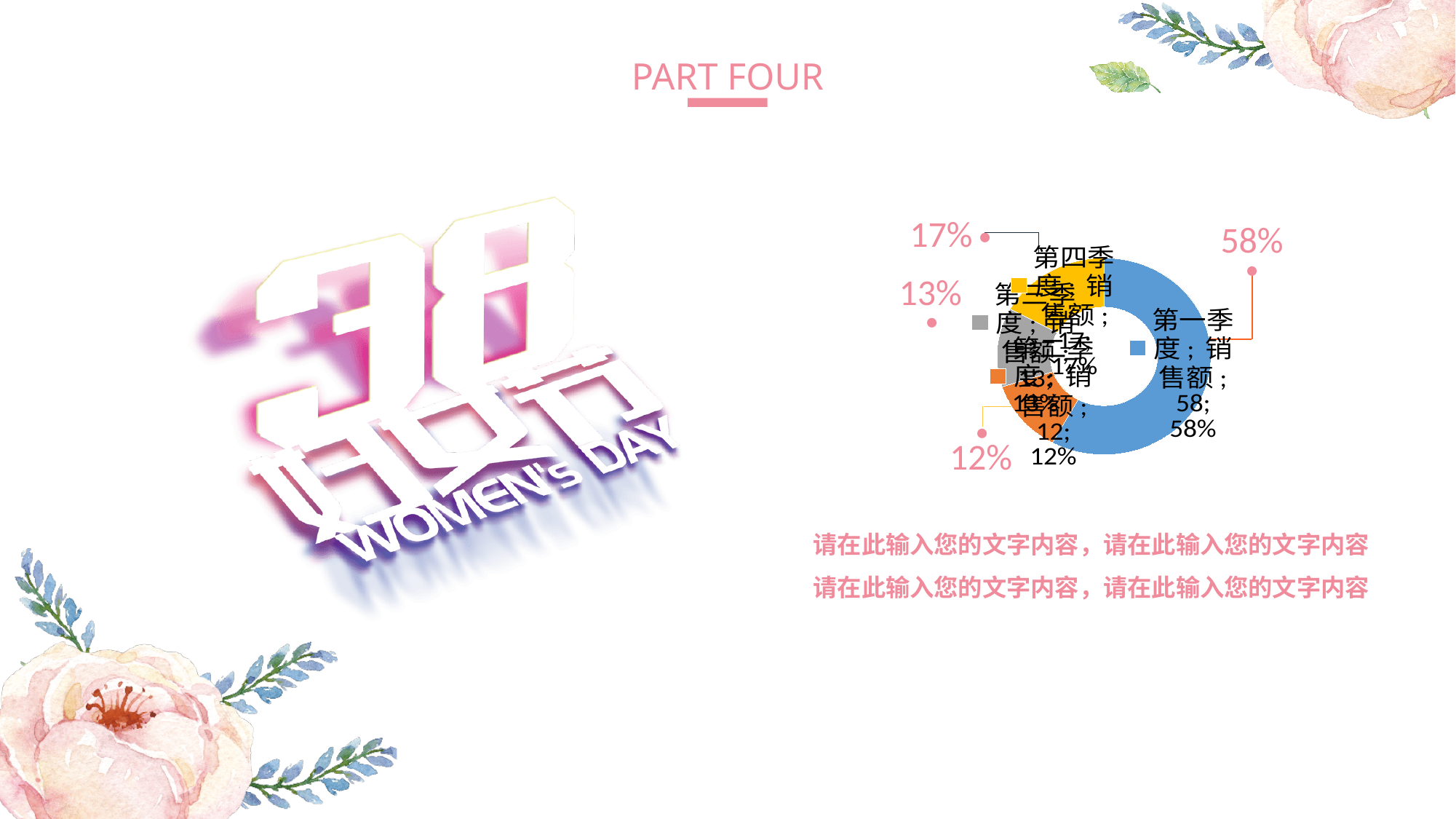
What percentage share does 第一季度 have in the chart? 58% Which quarter has the largest share of the doughnut chart? 第一季度 Is the share for 第一季度 greater or less than 50%? greater What is the sum of the four percentages shown around the chart (58%, 17%, 13%, 12%)? 100% What is the smallest percentage shown on the chart? 12% How many slices does the doughnut chart have? 4 What kind of chart is shown on the slide? doughnut (pie) chart What colour is the slice labelled 17%? yellow What is the difference in percentage points between the 第一季度 share (58%) and the 第四季度 share (17%)? 41 What percentage share does 第四季度 have in the chart? 17% Which has the larger share, 第一季度 or 第四季度? 第一季度 What colour is the 第一季度 slice in the chart? blue